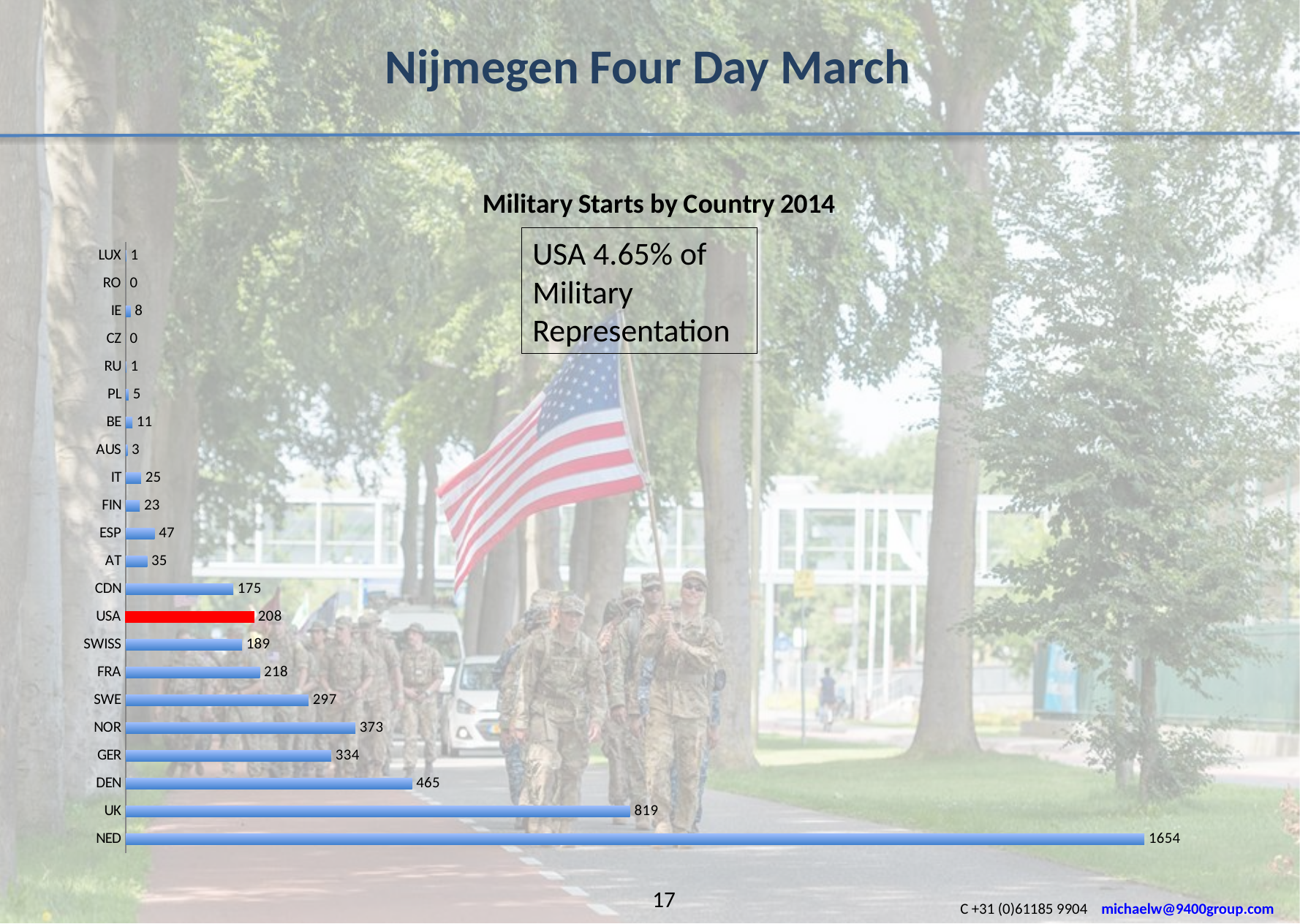
What is the title of the chart? Military Starts by Country 2014 What is the value for DEN in the chart? 465 What is the difference between the values for NED and UK? 835 What is the value for NOR in the chart? 373 What is the difference between the values for USA and CDN? 33 Which has a larger value, NOR or GER? NOR What type of chart is shown on the slide? bar chart Which country has the highest value in the chart? NED Which country's bar is coloured red in the chart? USA How many countries are listed in the chart? 22 Which has a larger value, FRA or USA? FRA What is the value for USA in the chart? 208